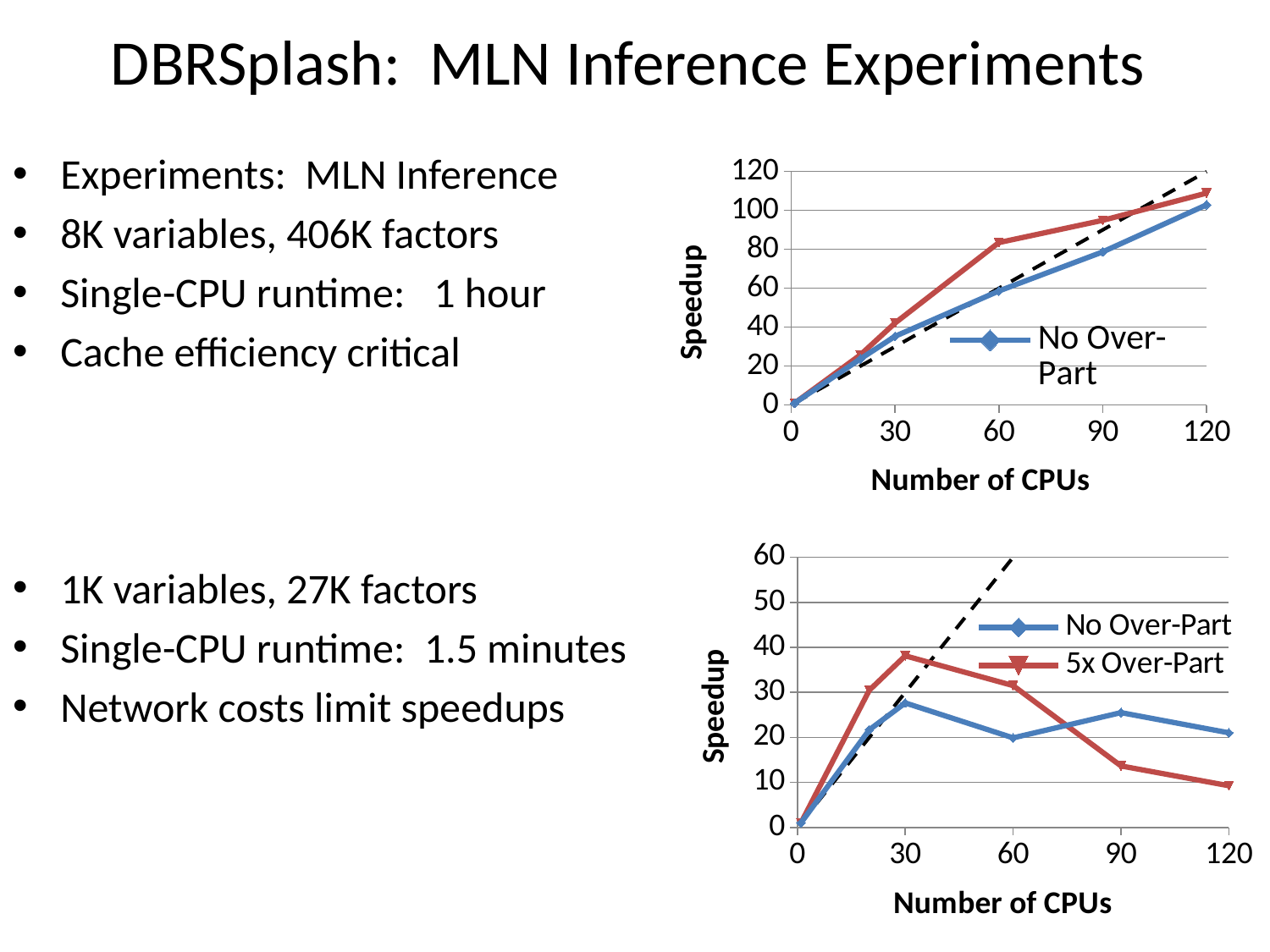
How many series does the legend of the bottom chart list? 2 In the top chart, at 60 CPUs, which line has the higher speedup, the red line or the blue No Over-Part line? the red line In the top chart, does the No Over-Part speedup rise or fall as the number of CPUs increases? rise In the bottom chart, at 90 CPUs, which series has the higher speedup, No Over-Part or 5x Over-Part? No Over-Part What kind of chart is the top chart on the slide? line chart In the bottom chart, does the 5x Over-Part speedup rise or fall between 30 and 120 CPUs? fall In the bottom chart, is the speedup of No Over-Part at 90 CPUs greater or less than 20? greater In the bottom chart, which series is plotted in red according to the legend? 5x Over-Part In the bottom chart, is the speedup of 5x Over-Part at 30 CPUs greater or less than 30? greater What is the x-axis label of the bottom chart? Number of CPUs In the top chart, is the speedup of the red line at 90 CPUs greater or less than 80? greater